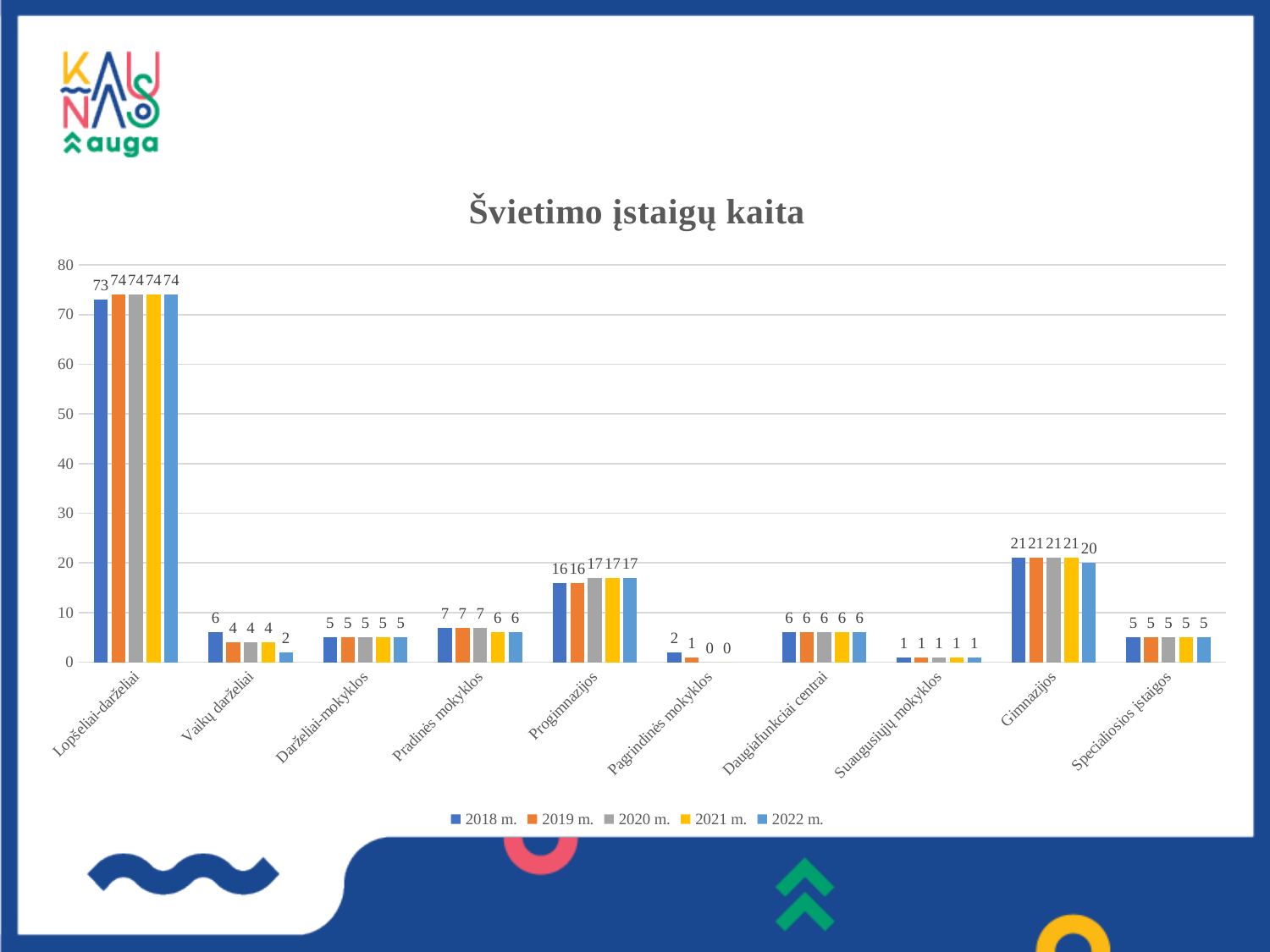
Do the values for Progimnazijos rise or fall from 2018 m. to 2022 m.? rise What is the value for Gimnazijos in 2022 m.? 20 Which category has the highest value in 2020 m.? Lopšeliai-darželiai How many categories are shown on the x axis? 10 How many series does the legend list? 5 What is the title of the chart? Švietimo įstaigų kaita What kind of chart is shown on the slide? bar chart What is the difference between the 2018 m. and 2022 m. values for Vaikų darželiai? 4 Which is larger: the 2018 m. value for Progimnazijos or the 2018 m. value for Gimnazijos? Gimnazijos What is the value for Lopšeliai-darželiai in 2018 m.? 73 What is the value for Vaikų darželiai in 2022 m.? 2 What is the value for Pagrindinės mokyklos in 2019 m.? 1